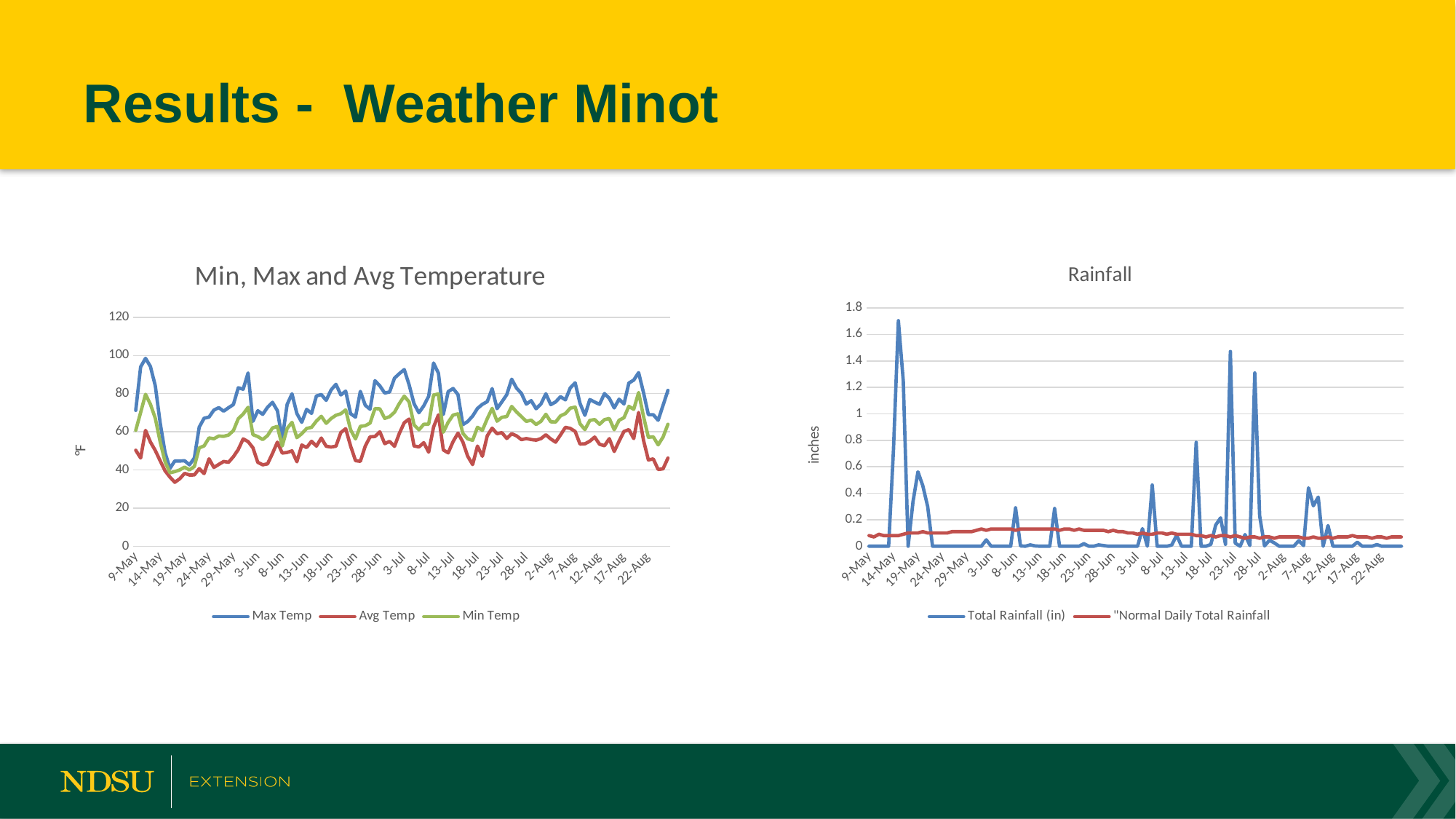
In the 'Min, Max and Avg Temperature' chart, is the Avg Temp value near 19-May greater or less than 40? less In the 'Rainfall' chart, does the 'Normal Daily Total Rainfall' line stay greater or less than 0.2 throughout the period? less In the 'Rainfall' chart, is the highest peak of Total Rainfall (in), near 14-May, greater or less than 1.6? greater In the 'Min, Max and Avg Temperature' chart, which series are listed in the legend? Max Temp, Avg Temp, Min Temp How many series does the legend of the 'Min, Max and Avg Temperature' chart list? 3 What kind of chart is the 'Min, Max and Avg Temperature' chart? line chart How many series does the legend of the 'Rainfall' chart list? 2 In the 'Min, Max and Avg Temperature' chart, which series has the highest values across the period? Max Temp What is the y-axis label of the 'Rainfall' chart? inches In the 'Min, Max and Avg Temperature' chart, which series has the lowest values across the period? Avg Temp